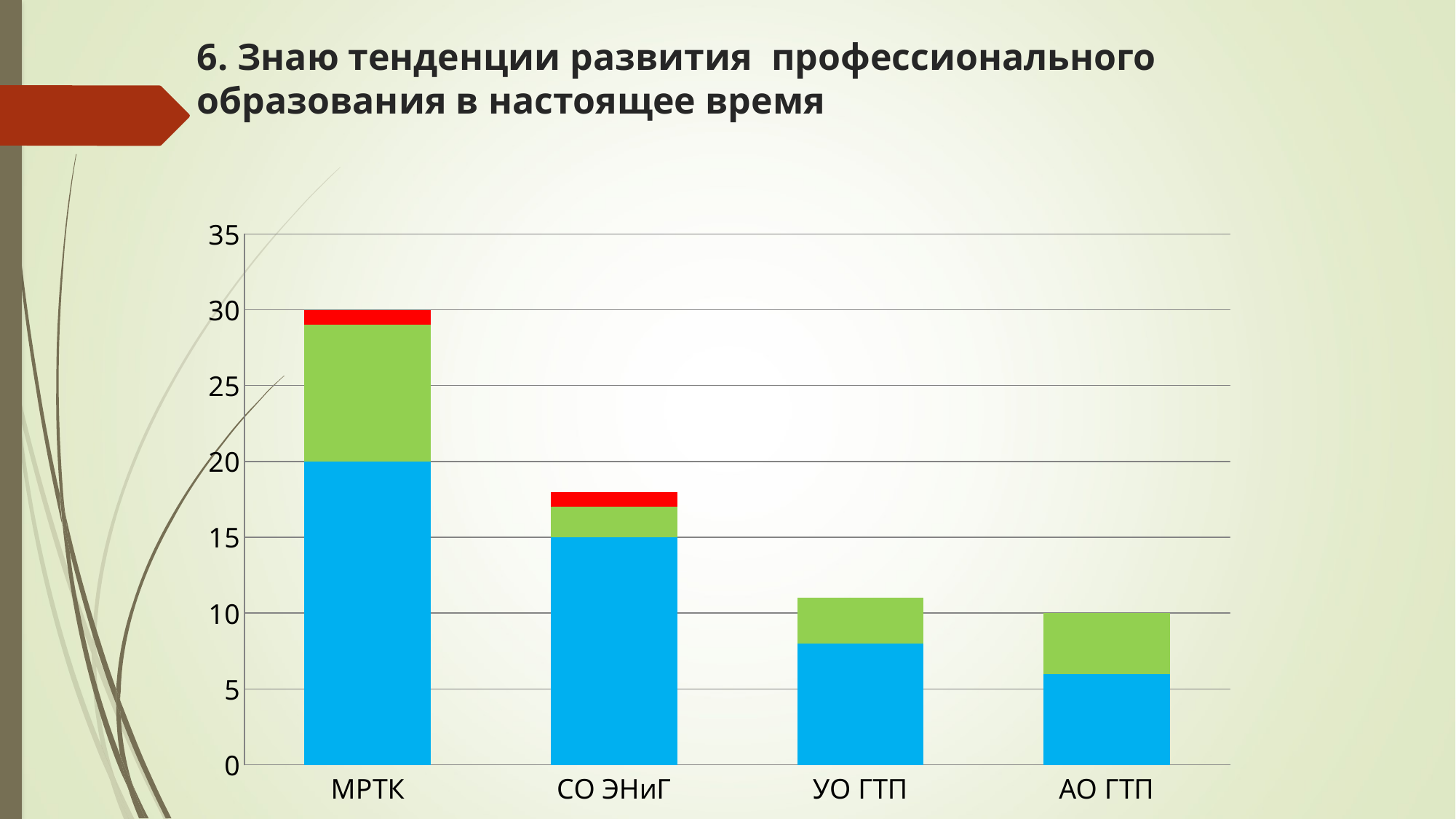
Do the total bar heights rise or fall from left to right along the x axis? fall What is the total height of the stacked bar for МРТК? 30 Which category has the tallest stacked bar? МРТК What is the value of the blue segment for СО ЭНиГ? 15 What is the difference between the total for МРТК and the total for АО ГТП? 20 What is the total height of the stacked bar for АО ГТП? 10 Which category has the shortest stacked bar? АО ГТП How many categories are shown on the x axis of the chart? 4 Is the total value for УО ГТП greater or less than 15? less What kind of chart is shown on the slide? bar chart Is the total value for СО ЭНиГ greater or less than 20? less What is the value of the blue segment for МРТК? 20